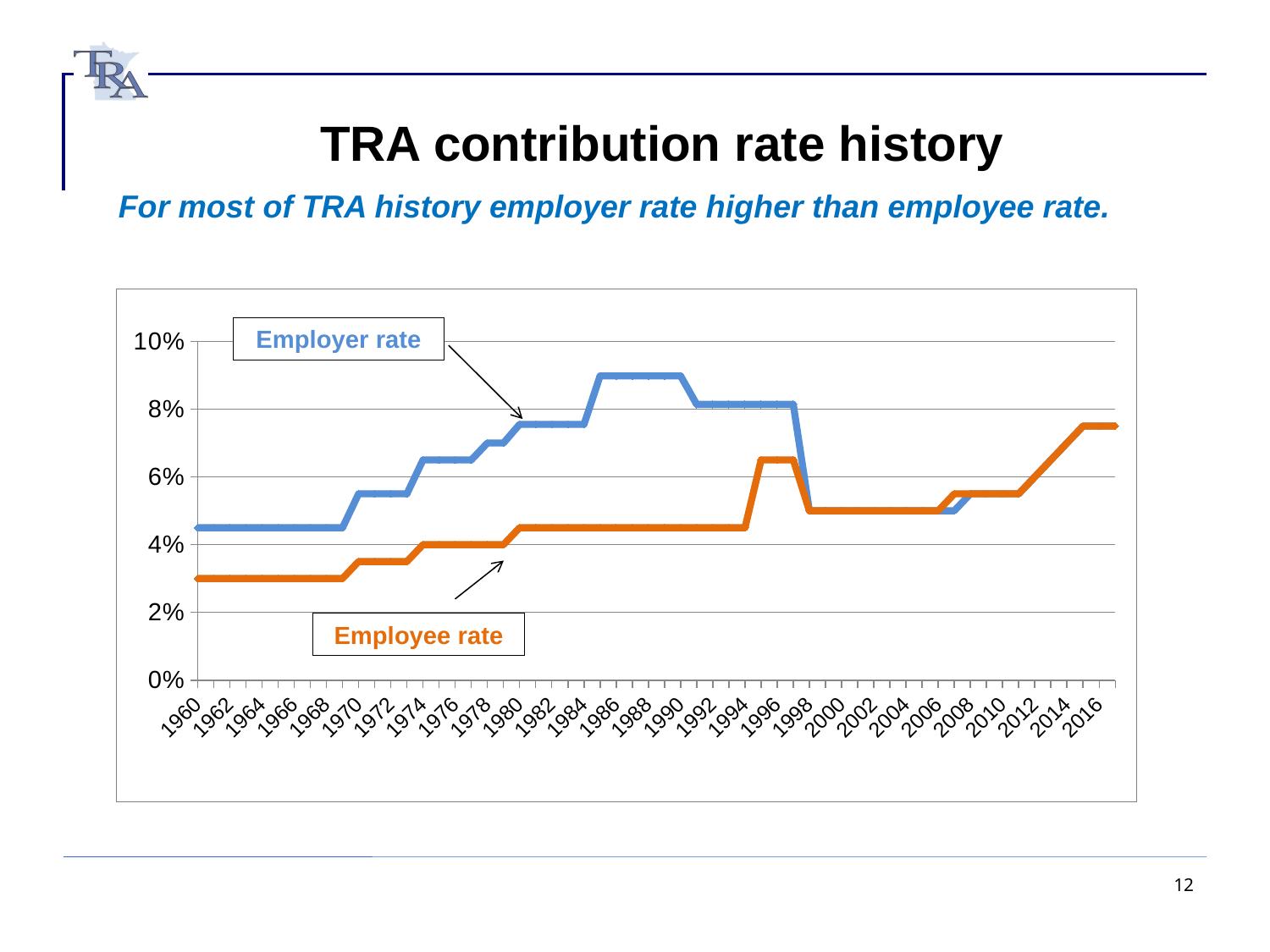
Is the Employee rate in 1960 greater or less than 4%? less What kind of chart is shown on the slide? Line chart In 1988, which is larger, the Employer rate or the Employee rate? Employer rate Is the Employee rate in 1996 greater or less than 6%? greater Does the Employer rate rise or fall between 1996 and 1998? Fall Is the Employer rate in 2000 greater or less than 6%? less What is the title of the slide's chart? TRA contribution rate history Does the Employee rate rise or fall between 2010 and 2016? Rise Which colour is used for the Employee rate line? Orange What is the Employee rate in 1976? 4% How many series does the chart plot? 2